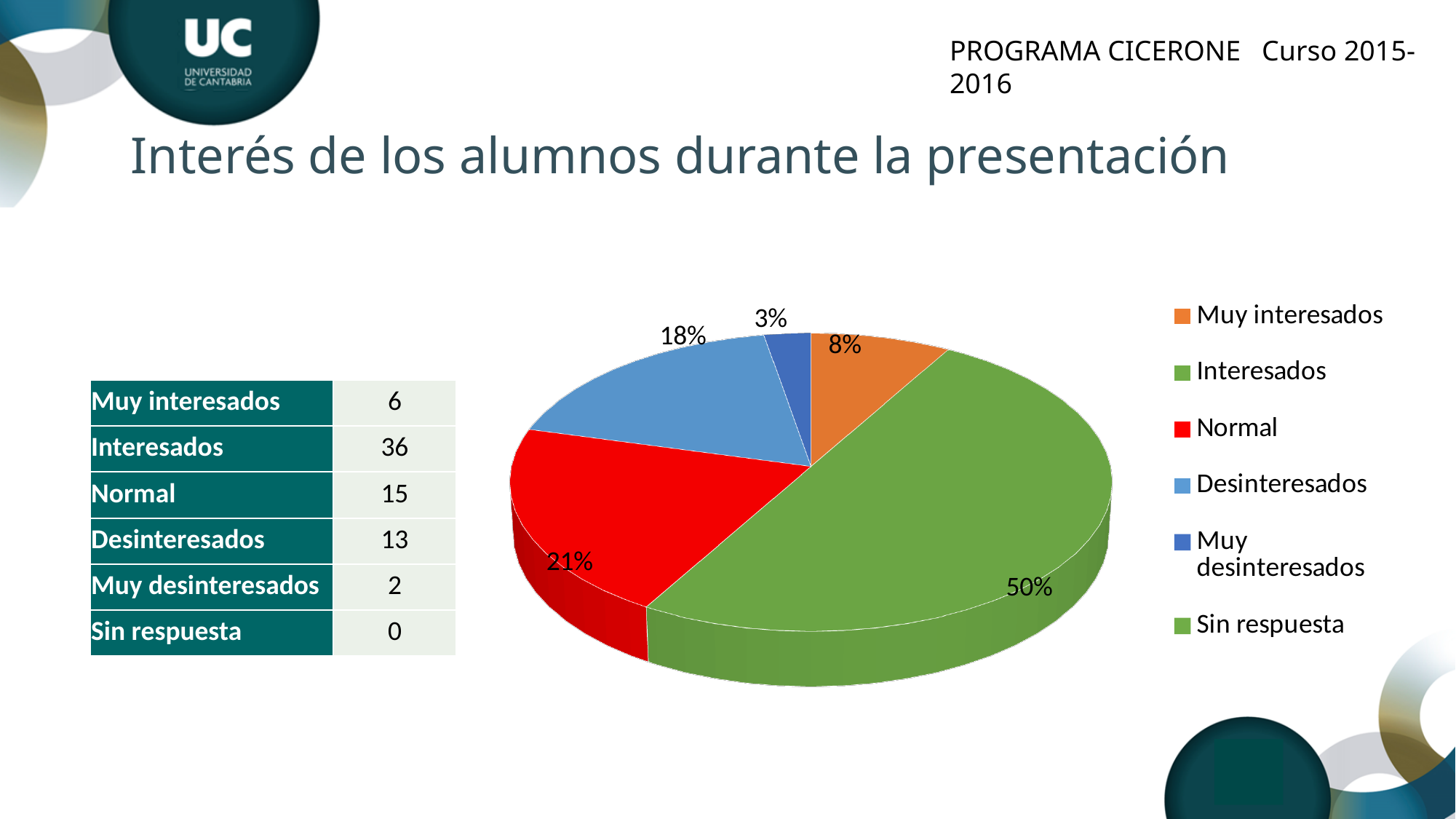
Which slice is larger in the pie chart, Muy interesados or Desinteresados? Desinteresados What percentage is shown for the Muy interesados slice in the pie chart? 8% Which category has the largest slice in the pie chart? Interesados What percentage is shown for the Muy desinteresados slice in the pie chart? 3% How many entries does the legend of the pie chart list? 6 What colour is the Normal slice in the pie chart? red What type of chart is shown on the slide? pie chart What percentage is shown for the Normal slice in the pie chart? 21% What is the difference in percentage points between the Normal slice and the Desinteresados slice? 3 What percentage of the pie chart does the Interesados slice represent? 50% Which labelled slice in the pie chart is the smallest? Muy desinteresados What percentage is shown for the Desinteresados slice in the pie chart? 18%